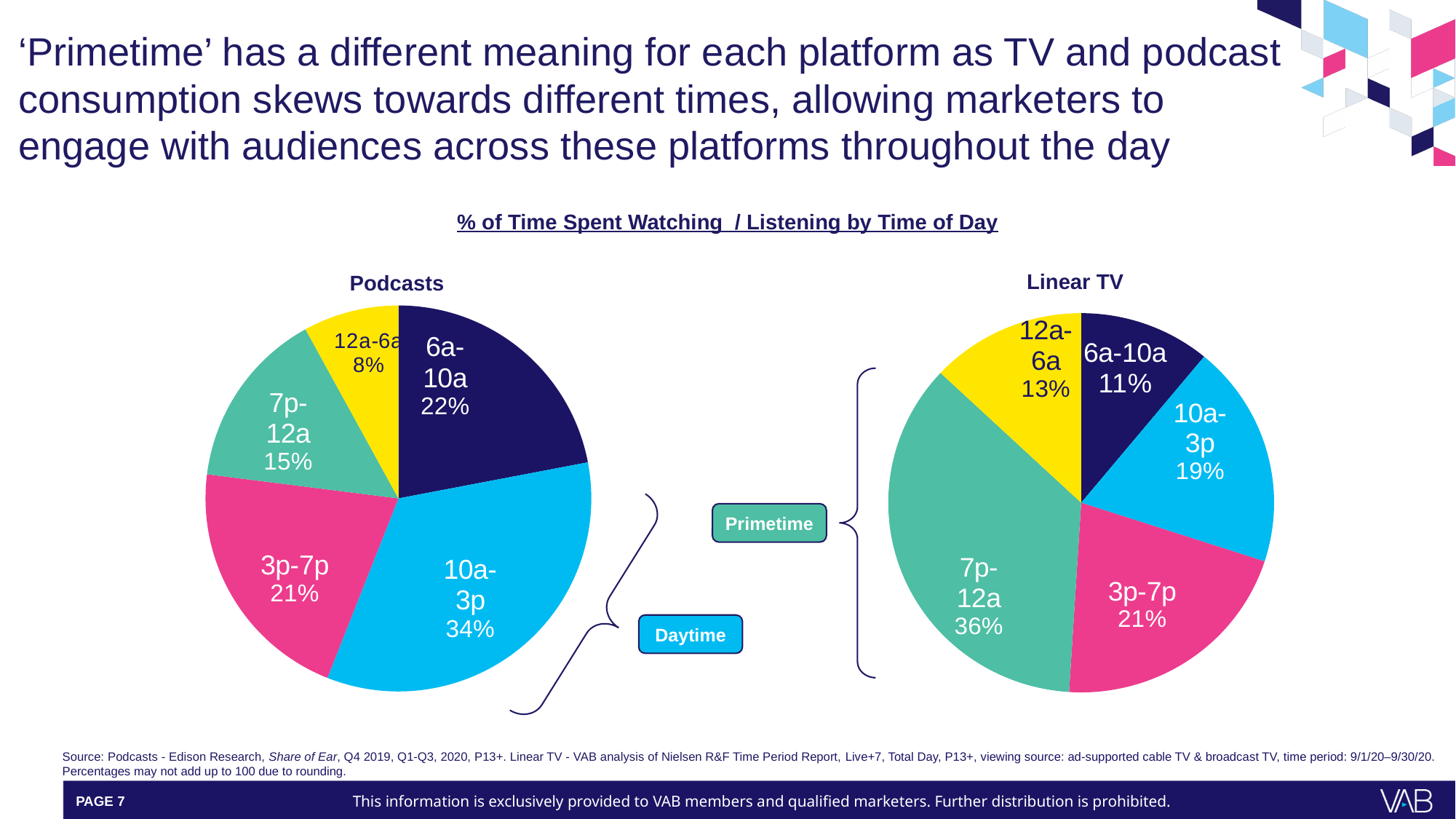
In the Linear TV pie chart, what is the difference in percentage points between the 7p-12a share and the 3p-7p share? 15 What kind of chart is used to show the Linear TV data? Pie chart In the Podcasts pie chart, what share of time is spent listening during 10a-3p? 34% Which is larger: the 6a-10a share in the Podcasts pie chart or the 6a-10a share in the Linear TV pie chart? Podcasts In the Linear TV pie chart, what share of time is spent watching during 12a-6a? 13% In the Podcasts pie chart, which time of day has the largest share? 10a-3p In the Podcasts pie chart, which time of day has the smallest share? 12a-6a In the Podcasts pie chart, what is the combined share of the 7p-12a and 12a-6a slices? 23% In the Linear TV pie chart, what share of time is spent watching during 7p-12a? 36% How many time-of-day slices does the Podcasts pie chart have? 5 In the Linear TV pie chart, which time of day has the smallest share? 6a-10a What is the title shown above the two pie charts? % of Time Spent Watching / Listening by Time of Day